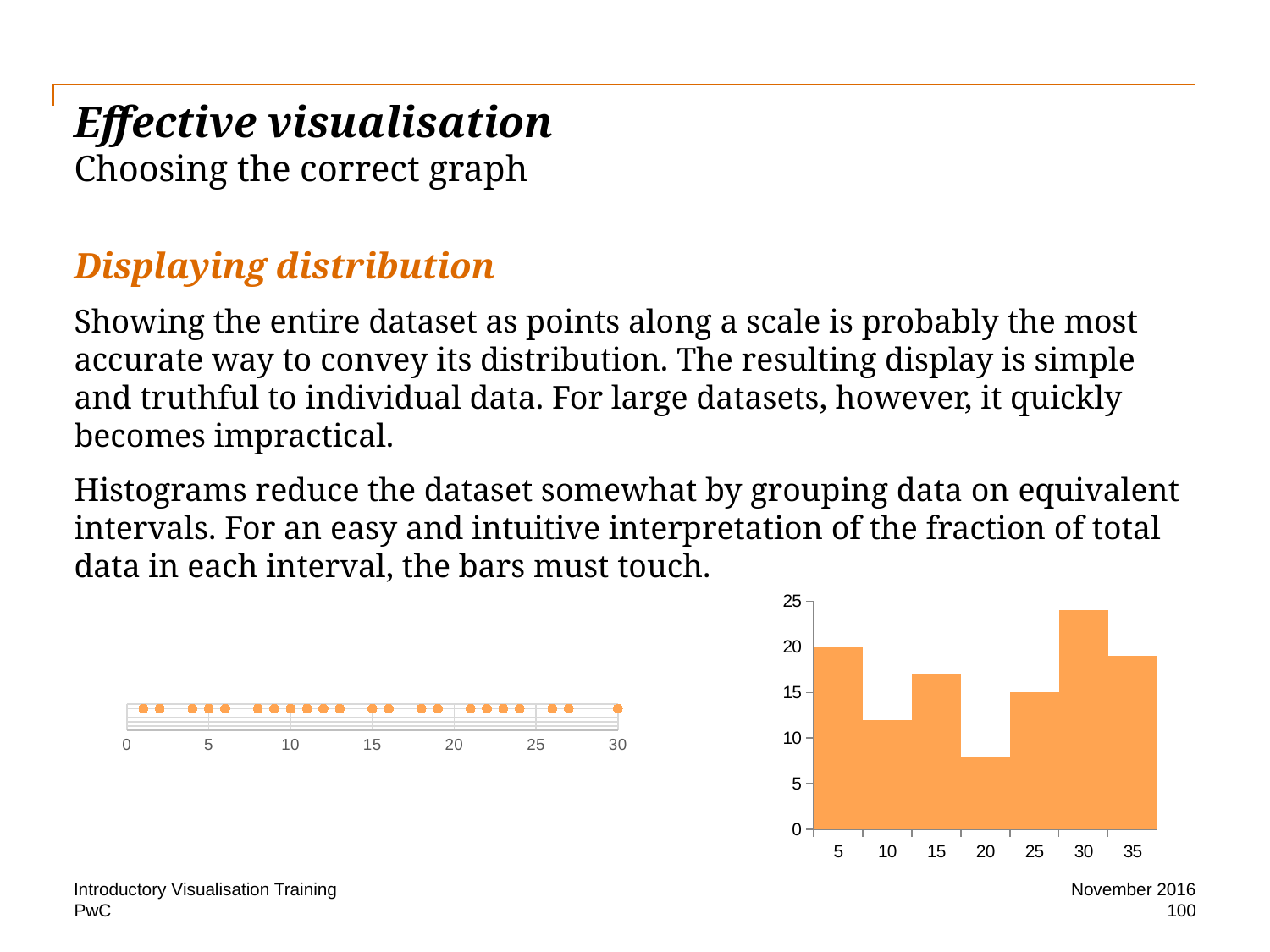
What kind of chart is the right-hand chart? bar chart (histogram) On the right-hand chart, which x-axis bin has the tallest bar? 30 On the right-hand chart, which bar is taller, the one at 25 or the one at 35? 35 On the right-hand chart, is the bar at 30 greater or less than 20? greater How many bars does the right-hand chart have? 7 On the right-hand chart, is the bar at 20 greater or less than 10? less On the right-hand chart, which bar is taller, the one at 5 or the one at 10? 5 What is the highest value shown on the y-axis of the right-hand chart? 25 On the right-hand chart, is the bar at 10 greater or less than 10? greater On the right-hand chart, which x-axis bin has the shortest bar? 20